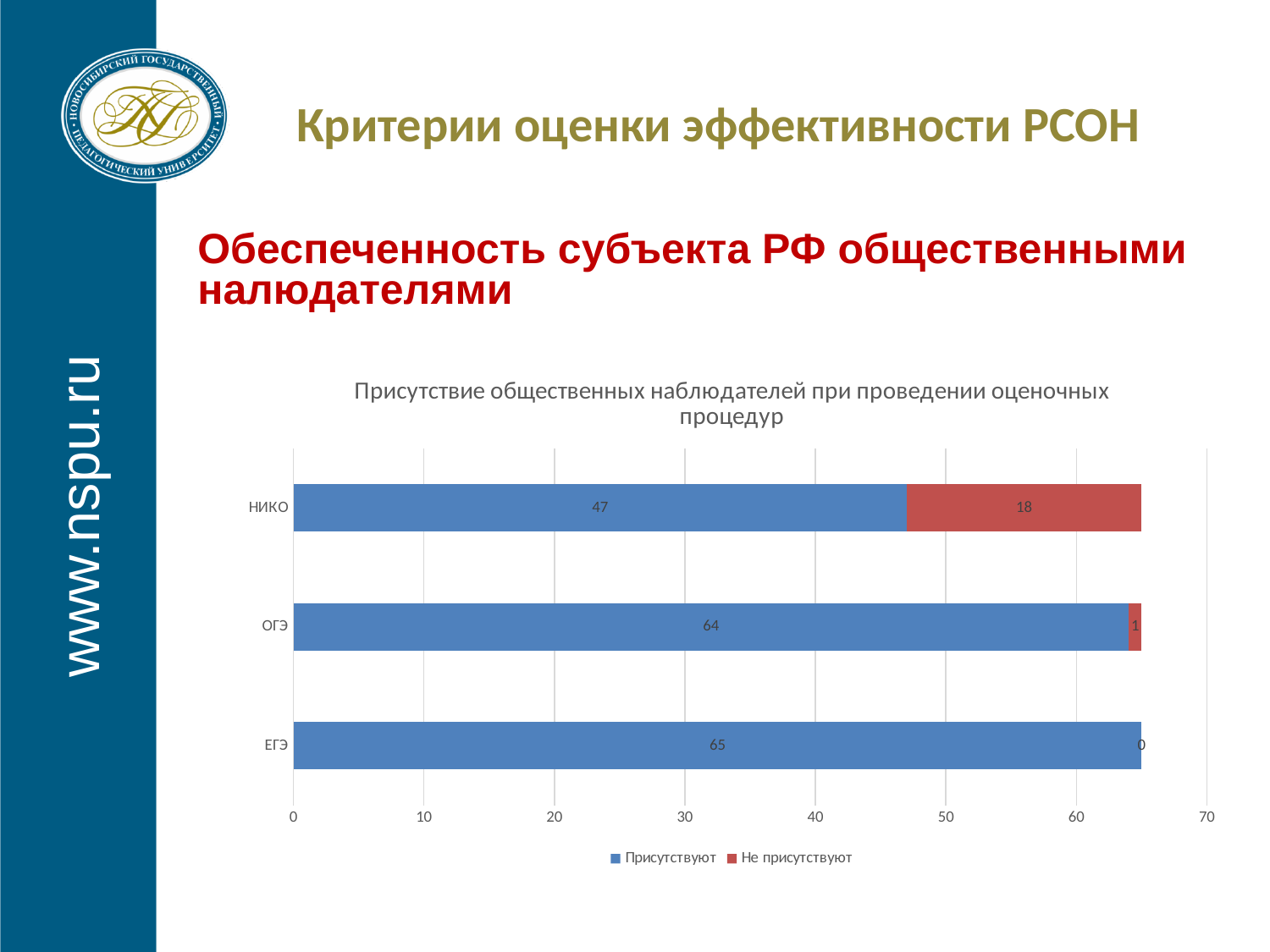
What is the value for "Присутствуют" for НИКО? 47 How many series does the legend list? 2 What is the total of the stacked bar for НИКО? 65 What is the value for "Не присутствуют" for ОГЭ? 1 Which category has the lowest value for "Присутствуют"? НИКО Which category has the highest value for "Присутствуют"? ЕГЭ What is the value for "Не присутствуют" for НИКО? 18 What is the difference between the "Присутствуют" values for ЕГЭ and НИКО? 18 What is the value for "Присутствуют" for ЕГЭ? 65 What is the value for "Присутствуют" for ОГЭ? 64 What kind of chart is shown on the slide? Bar chart How many categories are shown on the chart? 3